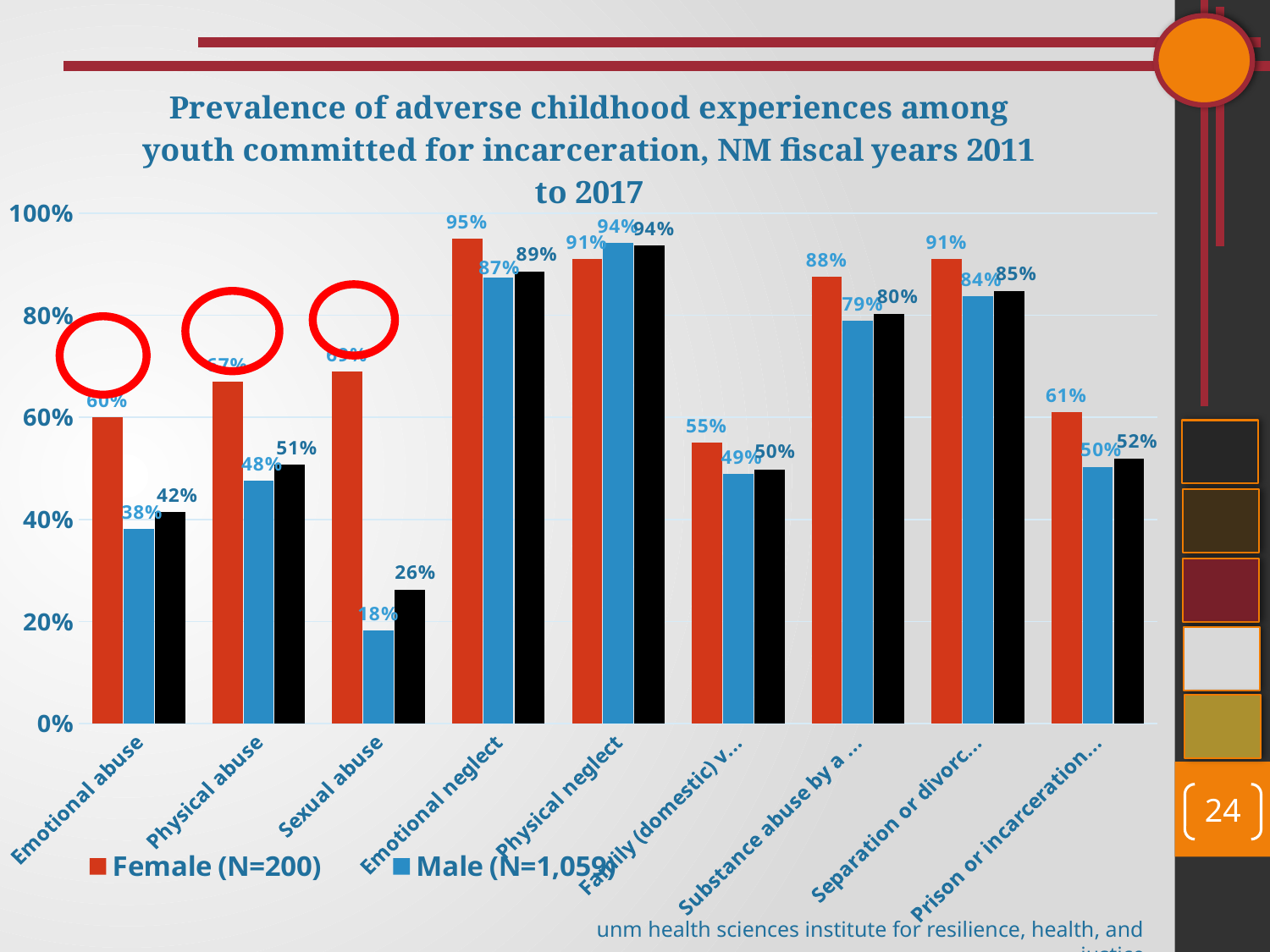
Which category has the lowest Male (N=1,059) value? Sexual abuse What is the Female (N=200) value for Emotional abuse? 60% What is the Female (N=200) value for Emotional neglect? 95% How many categories are shown on the x axis? 9 Is the Female (N=200) value for Sexual abuse greater or less than 60%? greater What is the Male (N=1,059) value for the 'Substance abuse by a ...' category? 79% For Physical neglect, which is larger: the Female (N=200) value or the Male (N=1,059) value? Male (N=1,059) Which category has the highest Female (N=200) value? Emotional neglect What is the Male (N=1,059) value for Sexual abuse? 18% What kind of chart is shown on the slide? Bar chart For Emotional abuse, how many percentage points higher is the Female value than the Male value? 22 percentage points What colour represents the Female (N=200) series in the legend? Red